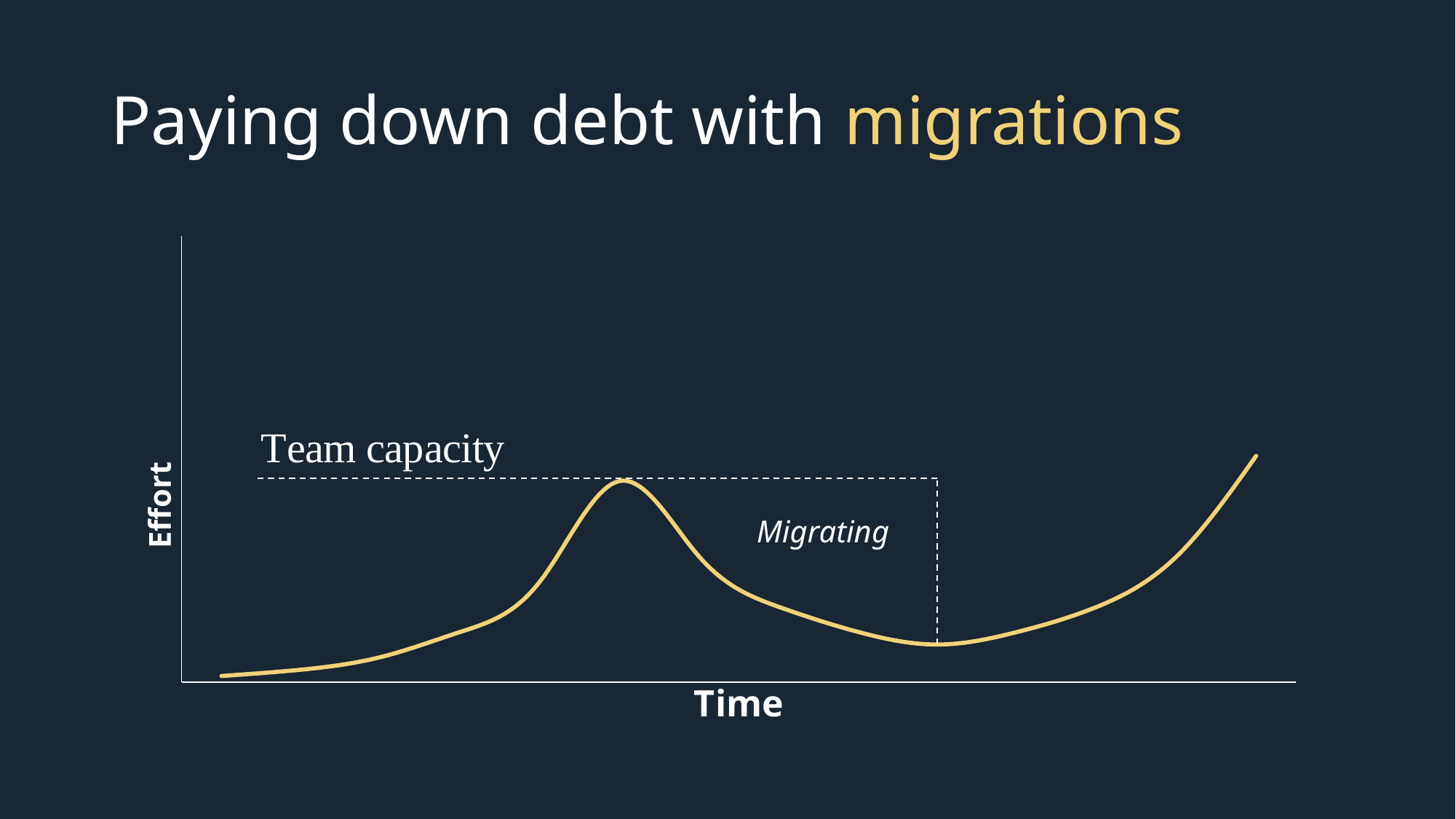
After the end of the "Migrating" period, does effort rise or fall as time increases? rise How many lines (series) are plotted in the chart? 1 What kind of chart is shown on the slide? line chart What does the dashed horizontal line in the chart represent? Team capacity What is the label on the vertical axis of the chart? Effort Before the peak of the curve, does effort rise or fall as time increases? rise During the period labelled "Migrating", does effort rise or fall over time? fall Is effort lower at the start of the curve or at the end of the "Migrating" period? start of the curve Is effort higher at the right end of the curve or at the peak near the Team capacity line? right end